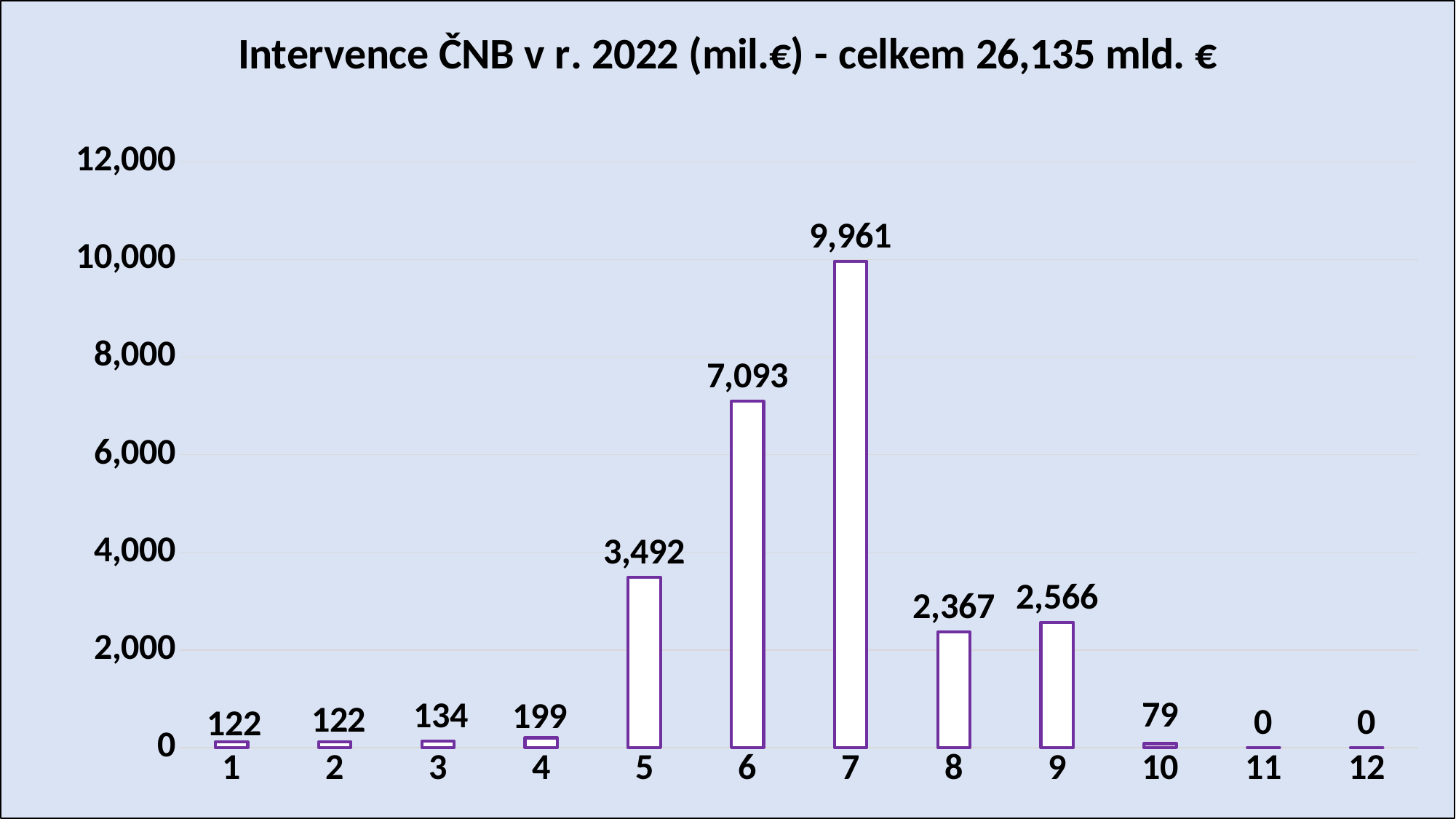
What is the value for category 7? 9,961 What is the difference between the values for categories 9 and 8? 199 How many categories are shown on the x axis? 12 What kind of chart is shown? bar chart Which category has the highest value? 7 What is the value for category 10? 79 Is the value for category 6 greater or less than 6,000? greater Do the values rise or fall from category 7 to category 8? fall What is the title of the chart? Intervence ČNB v r. 2022 (mil.€) - celkem 26,135 mld. € Which is larger, the value for category 4 or the value for category 3? 4 What is the value for category 5? 3,492 What is the difference between the values for categories 7 and 6? 2,868